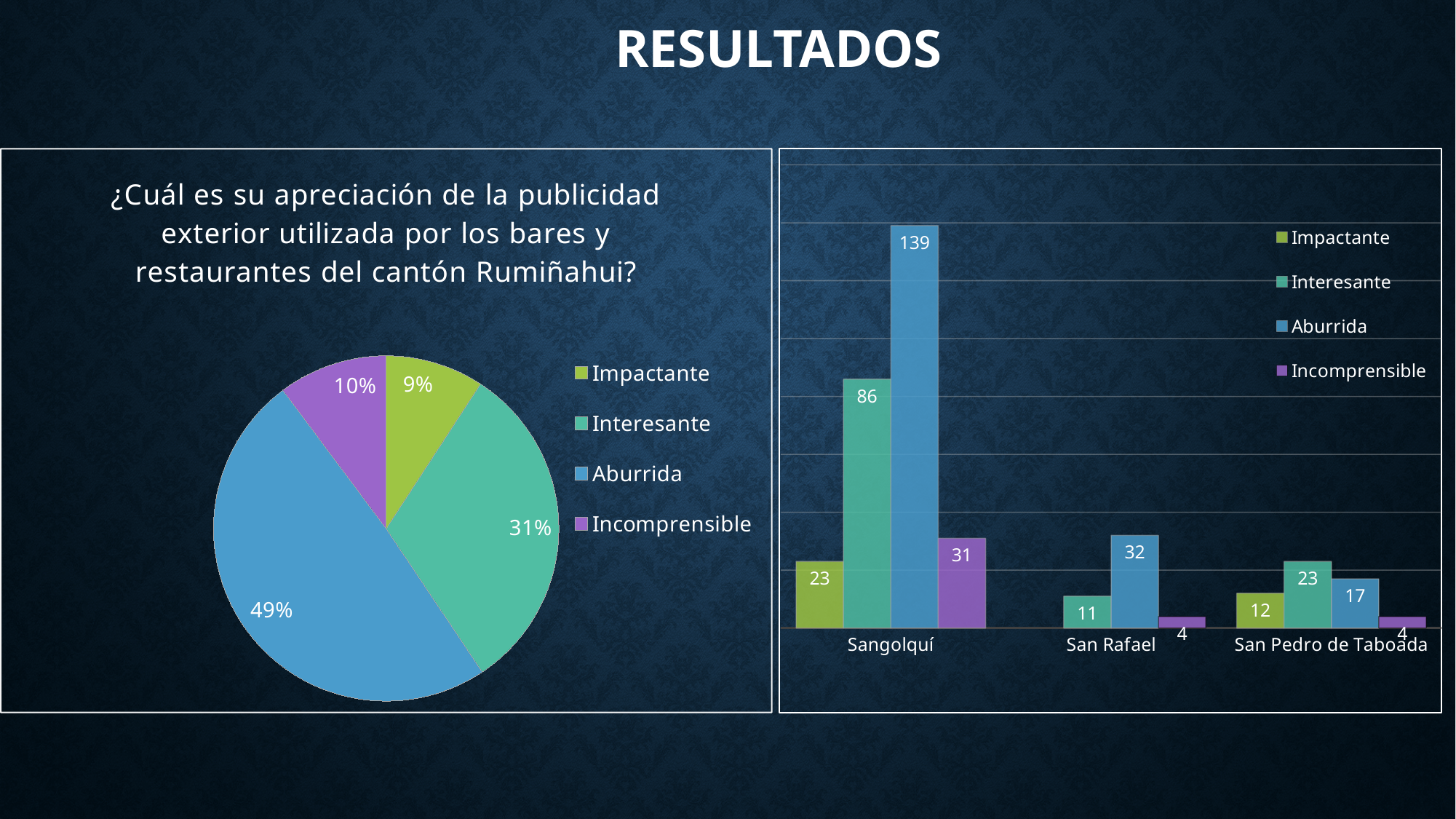
In the bar chart on the right, what is the difference between 'Aburrida' and 'Interesante' in Sangolquí? 53 In the bar chart on the right, which location has the highest value for 'Incomprensible'? Sangolquí In the bar chart on the right, how many location categories are shown on the x axis? 3 In the pie chart on the left, what share of responses is 'Impactante'? 9% In the pie chart on the left, which category has the smallest slice? Impactante In the pie chart on the left, which category has the largest slice? Aburrida In the bar chart on the right, what is the value for 'Aburrida' in Sangolquí? 139 In the pie chart on the left, how many categories does the legend list? 4 In the bar chart on the right, what is the value for 'Interesante' in San Pedro de Taboada? 23 In the pie chart on the left, what share of responses is 'Aburrida'? 49% What kind of chart is on the right side of the slide? Bar chart